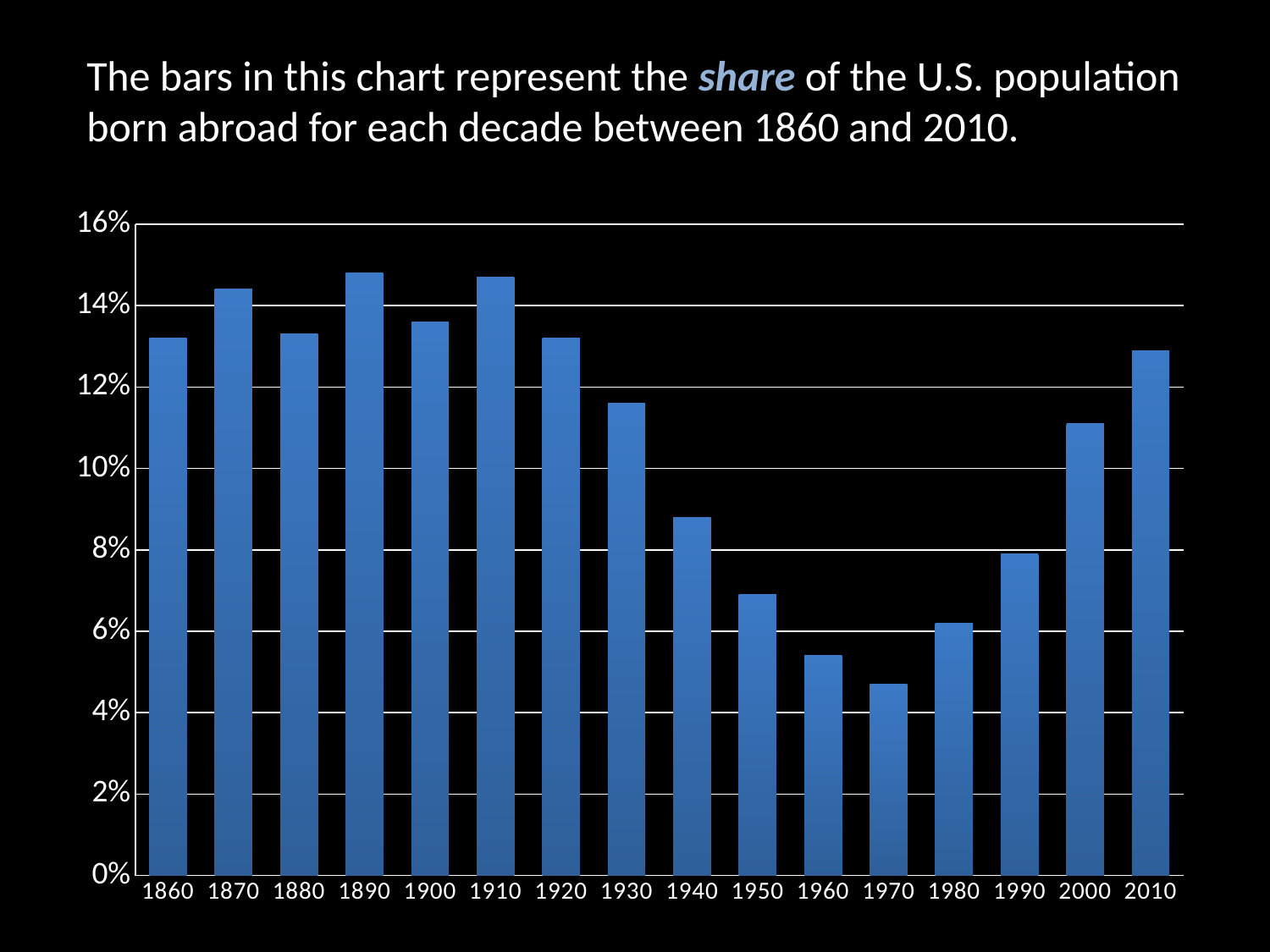
What kind of chart is shown on the slide? bar chart What is the highest value shown on the vertical axis? 16% Is the value for 1930 greater or less than 10%? greater Do the values rise or fall from 1920 to 1970? fall Is the value for 1940 greater or less than 10%? less Which is larger, the value for 2000 or the value for 2010? 2010 Which decade has the lowest share of the U.S. population born abroad? 1970 Is the value for 1890 greater or less than 14%? greater How many decades (bars) are plotted in the chart? 16 Which is larger, the value for 1870 or the value for 1880? 1870